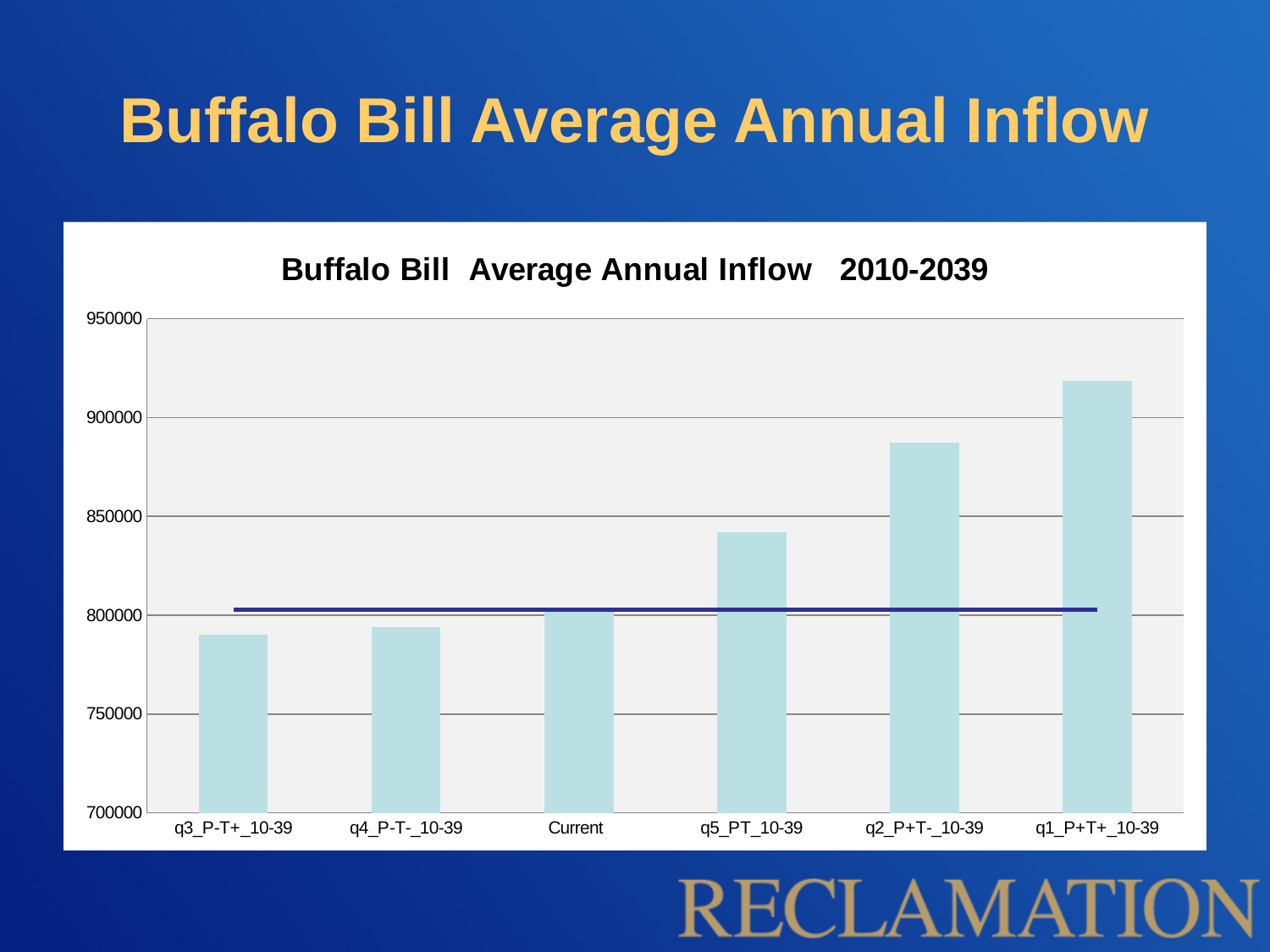
What is the title printed above the chart? Buffalo Bill Average Annual Inflow 2010-2039 Is the value for q3_P-T+_10-39 greater or less than 800000? less Is the value for q2_P+T-_10-39 greater or less than 900000? less Which is larger, the value for q2_P+T-_10-39 or the value for q5_PT_10-39? q2_P+T-_10-39 Is the value for q5_PT_10-39 greater or less than 850000? less Which is larger, the value for Current or the value for q1_P+T+_10-39? q1_P+T+_10-39 Do the bar values generally rise or fall from left to right along the x axis? rise What kind of chart is shown on the slide? combination bar and line chart Which category has the highest average annual inflow? q1_P+T+_10-39 How many categories are plotted along the x axis? 6